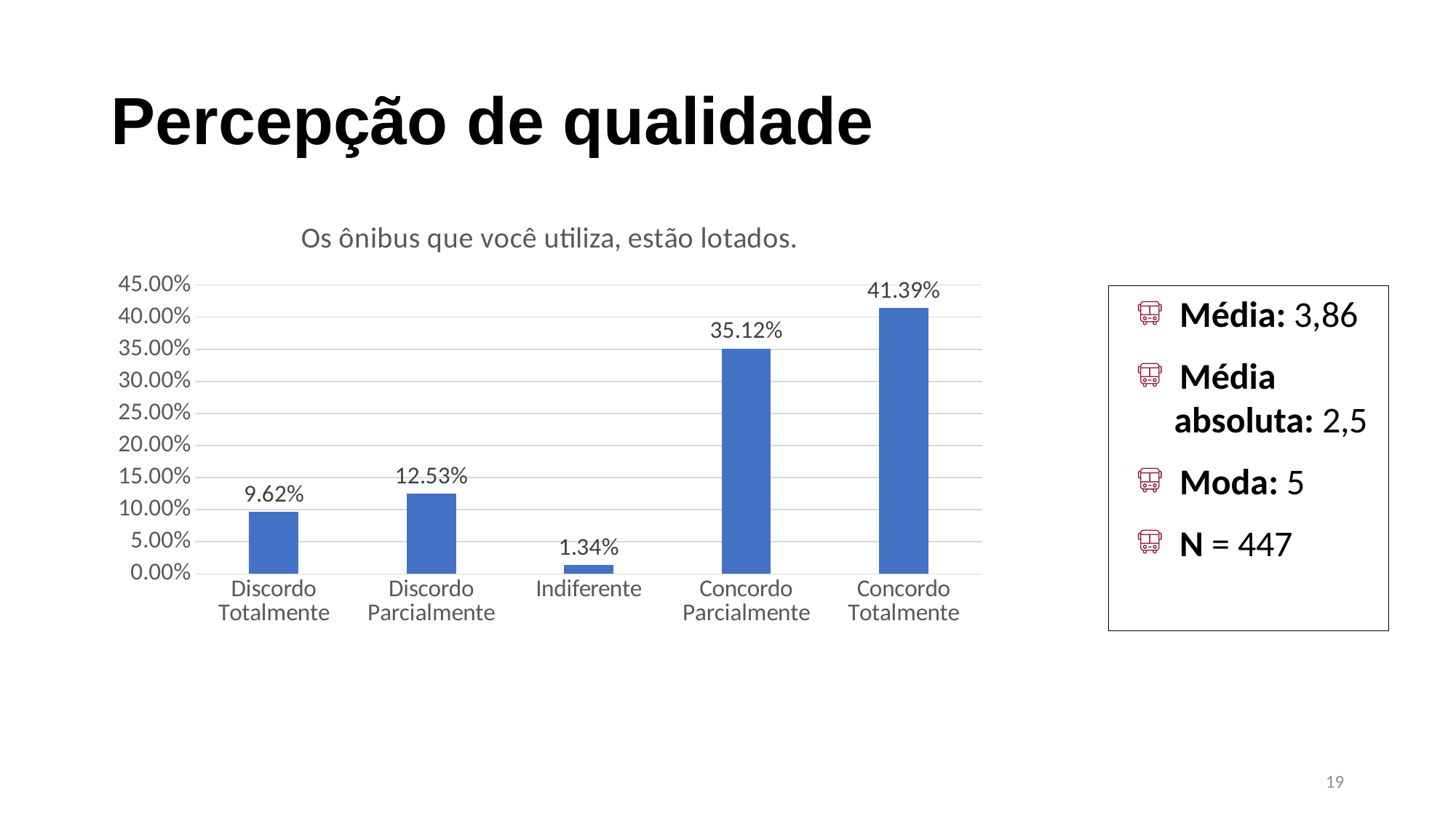
What is the title of the chart? Os ônibus que você utiliza, estão lotados. Which category has the highest value? Concordo Totalmente How many categories are shown on the x axis? 5 What is the value for Discordo Parcialmente? 12.53% What is the difference between Discordo Parcialmente and Discordo Totalmente? 2.91% What is the difference between Concordo Totalmente and Concordo Parcialmente? 6.27% Which category has the lowest value? Indiferente Is the value for Concordo Parcialmente greater or less than 30.00%? greater Which is larger, Discordo Totalmente or Discordo Parcialmente? Discordo Parcialmente What is the value for Indiferente? 1.34% What is the value for Concordo Totalmente? 41.39% What kind of chart is shown on the slide? Bar chart